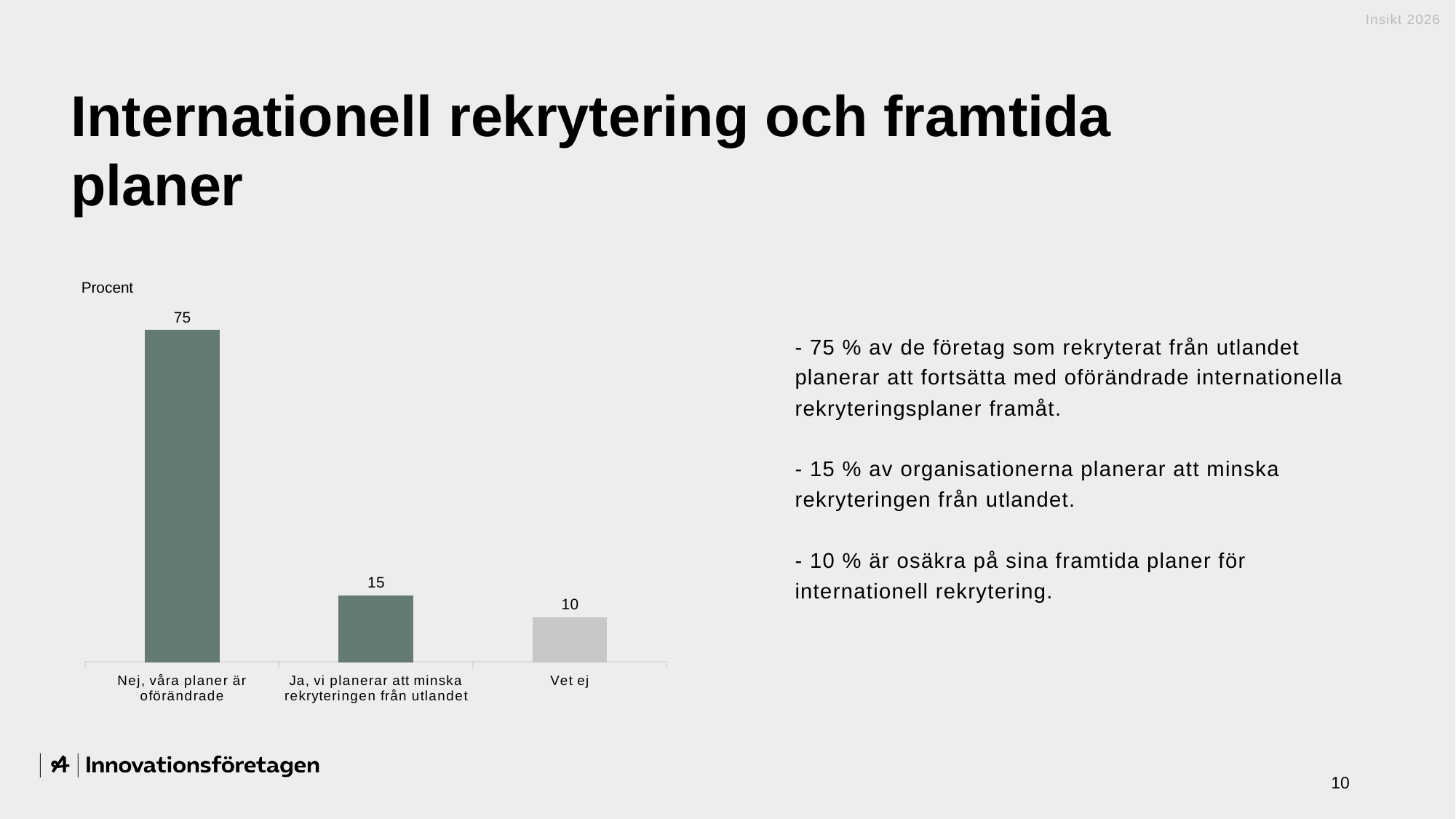
What is the difference between the values for "Ja, vi planerar att minska rekryteringen från utlandet" and "Vet ej"? 5 How many categories are shown in the chart? 3 What is the value for "Ja, vi planerar att minska rekryteringen från utlandet"? 15 Which category has the lowest value? Vet ej What is the value for "Vet ej"? 10 Which category has the highest value? Nej, våra planer är oförändrade What kind of chart is shown on the slide? Bar chart Do the values rise or fall from left to right across the categories? Fall What unit label is shown above the chart's vertical axis? Procent Which is larger, the value for "Ja, vi planerar att minska rekryteringen från utlandet" or the value for "Vet ej"? Ja, vi planerar att minska rekryteringen från utlandet What is the difference between the values for "Nej, våra planer är oförändrade" and "Ja, vi planerar att minska rekryteringen från utlandet"? 60 What is the value for "Nej, våra planer är oförändrade"? 75